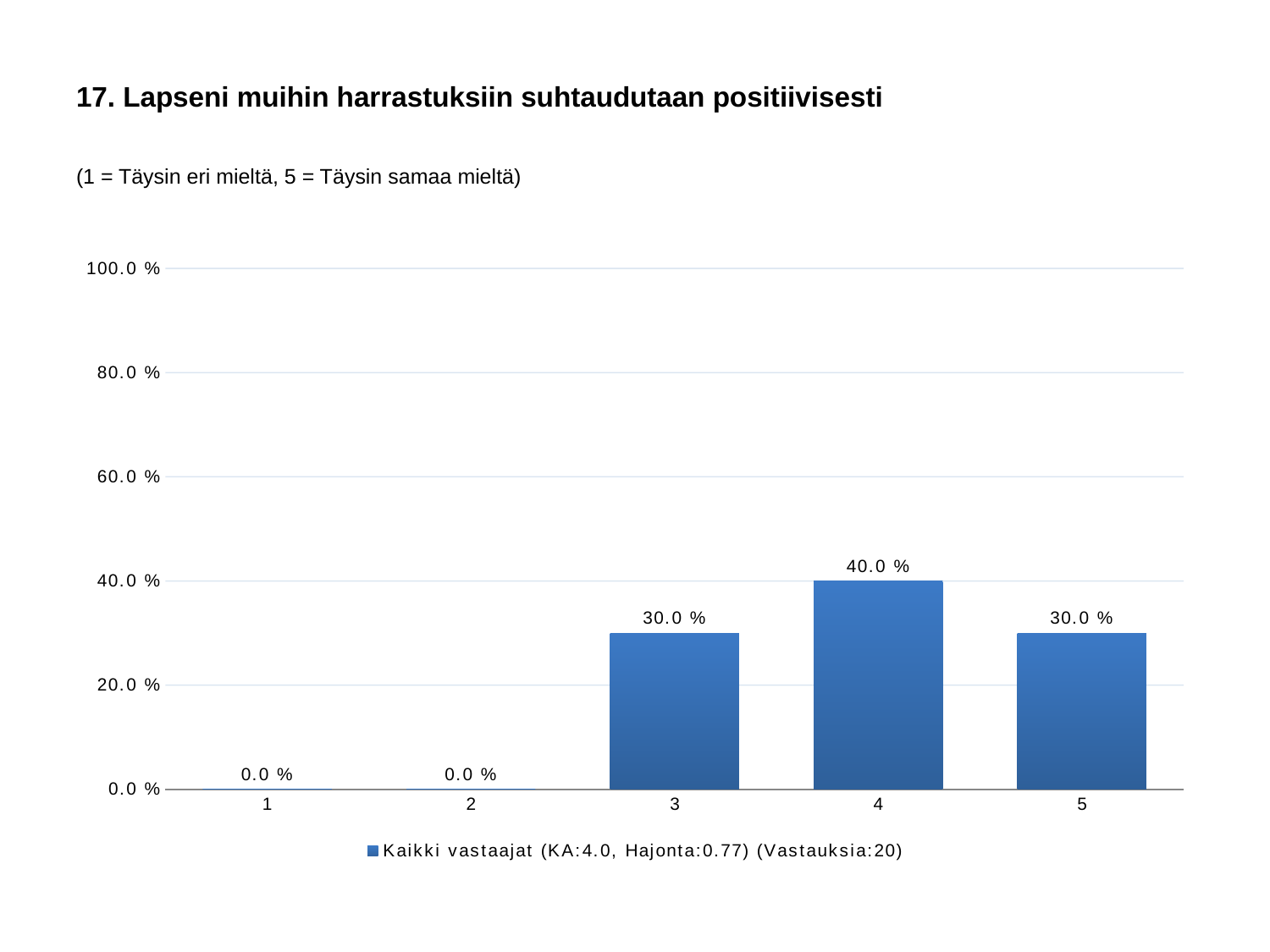
How many categories are shown on the x axis? 5 Is the value for category 5 greater or less than 20.0 %? greater What is the total of the values for categories 3, 4 and 5? 100.0 % What is the value for category 3? 30.0 % What is the value for category 1? 0.0 % What kind of chart is shown? bar chart What is the legend entry for the series? Kaikki vastaajat (KA:4.0, Hajonta:0.77) (Vastauksia:20) What is the difference between the values for category 4 and category 5? 10.0 % How many series does the legend list? 1 Which is larger, the value for category 3 or the value for category 4? 4 Which category has the highest value? 4 What is the value for category 4? 40.0 %